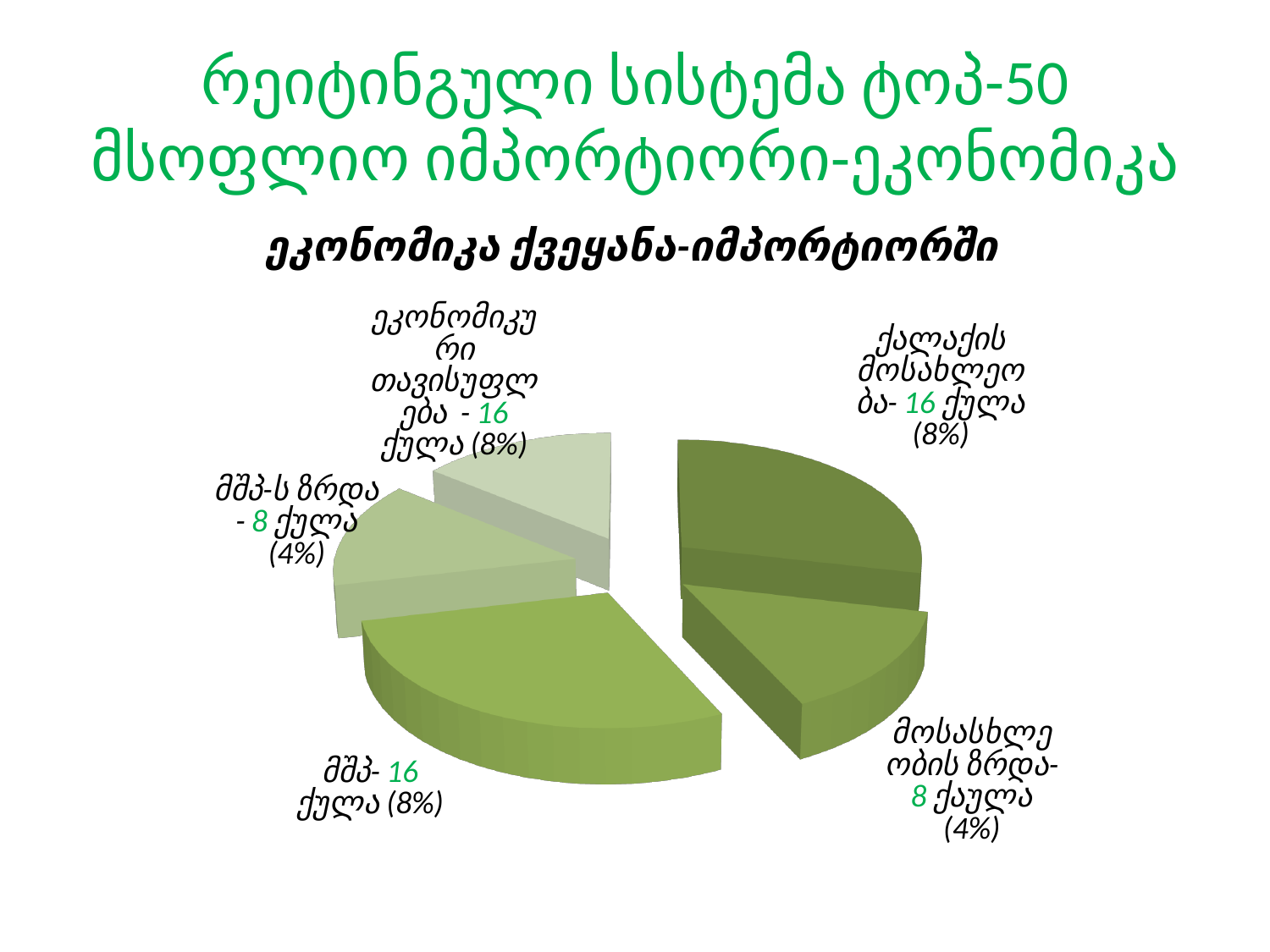
How many points are shown for მოსახლეობის ზრდა? 8 Which has more points, მშპ or მოსახლეობის ზრდა? მშპ What percentage share is shown for მშპ-ს ზრდა? 4% How many points are shown for მშპ? 16 How many points (ქულა) are shown for ქალაქის მოსახლეობა? 16 What is the title of the chart? ეკონომიკა ქვეყანა-იმპორტიორში How many points are shown for მშპ-ს ზრდა? 8 What kind of chart is shown on the slide? pie chart What percentage share is shown for ეკონომიკური თავისუფლება? 8% How many points are shown for ეკონომიკური თავისუფლება? 16 What is the difference in points between ქალაქის მოსახლეობა and მშპ-ს ზრდა? 8 How many slices does the pie chart have? 5